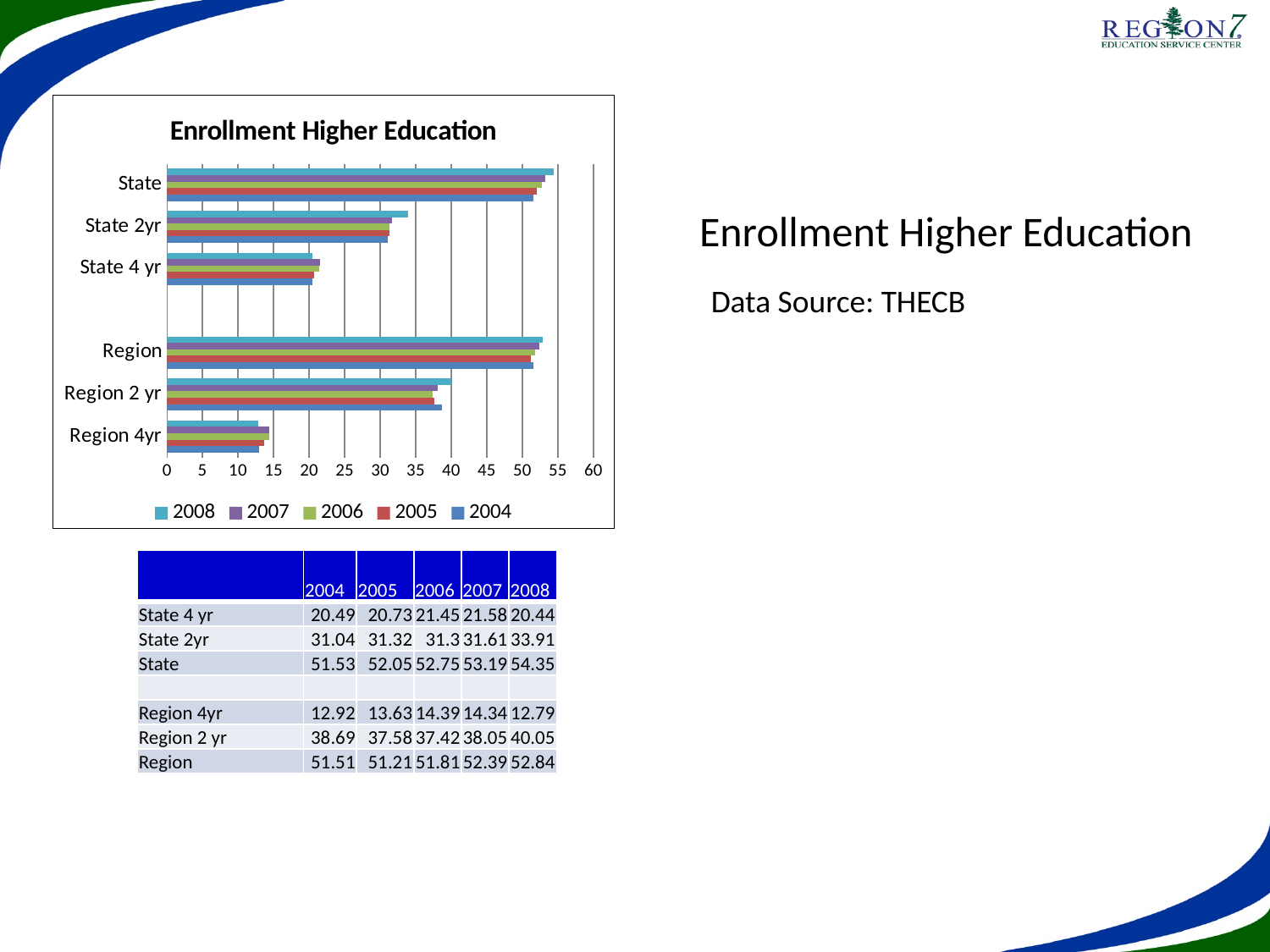
What is the title of the chart? Enrollment Higher Education How many categories are plotted on the chart? 6 What is the difference between the State value in 2008 and the State value in 2004? 2.82 Is the value for Region in 2008 greater or less than 50? greater What is the value for Region 4yr in 2004? 12.92 Do the State values rise or fall from 2004 to 2008? rise What kind of chart is shown on the slide? bar chart Is the value for State 4 yr in 2008 greater or less than 25? less What is the value for State in 2008? 54.35 Which category has the lowest value for 2008? Region 4yr How many series does the legend of the chart list? 5 Which is larger in 2008: Region 2 yr or State 2yr? Region 2 yr